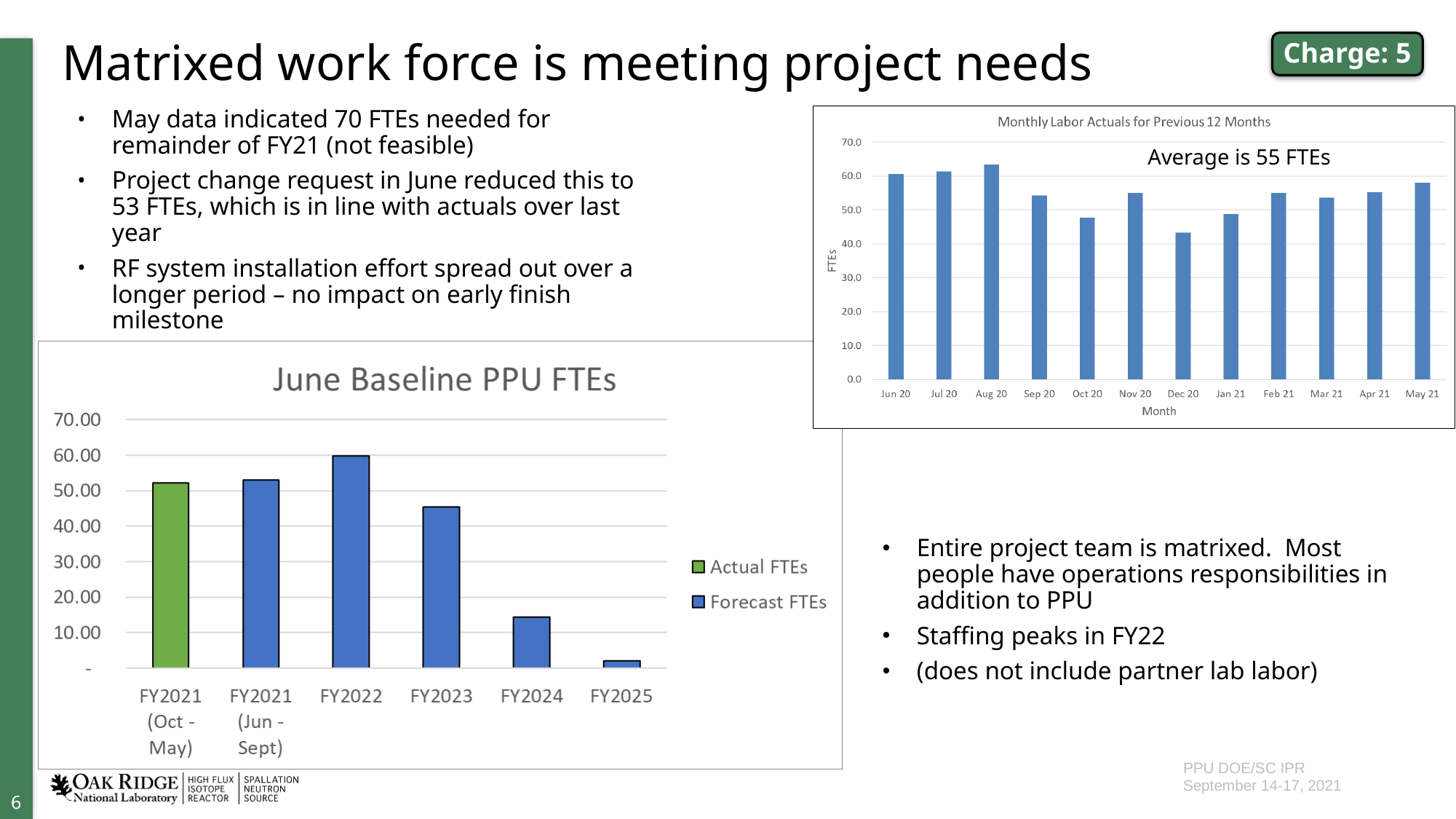
In the June Baseline PPU FTEs chart, how many series does the legend list? 2 In the Monthly Labor Actuals for Previous 12 Months chart, is the value for Oct 20 greater or less than 50.0? less In the June Baseline PPU FTEs chart, how many categories are shown on the x axis? 6 In the June Baseline PPU FTEs chart, which series is shown in green? Actual FTEs In the June Baseline PPU FTEs chart, is the value for FY2022 greater or less than 50.00? greater In the June Baseline PPU FTEs chart, which category has the lowest value? FY2025 In the Monthly Labor Actuals for Previous 12 Months chart, which is larger, the value for Jul 20 or the value for Dec 20? Jul 20 In the June Baseline PPU FTEs chart, which category has the highest value? FY2022 In the Monthly Labor Actuals for Previous 12 Months chart, which month has the highest value? Aug 20 In the Monthly Labor Actuals for Previous 12 Months chart, which month has the lowest value? Dec 20 What kind of chart is the Monthly Labor Actuals for Previous 12 Months chart? bar chart In the June Baseline PPU FTEs chart, is the value for FY2024 greater or less than 20.00? less